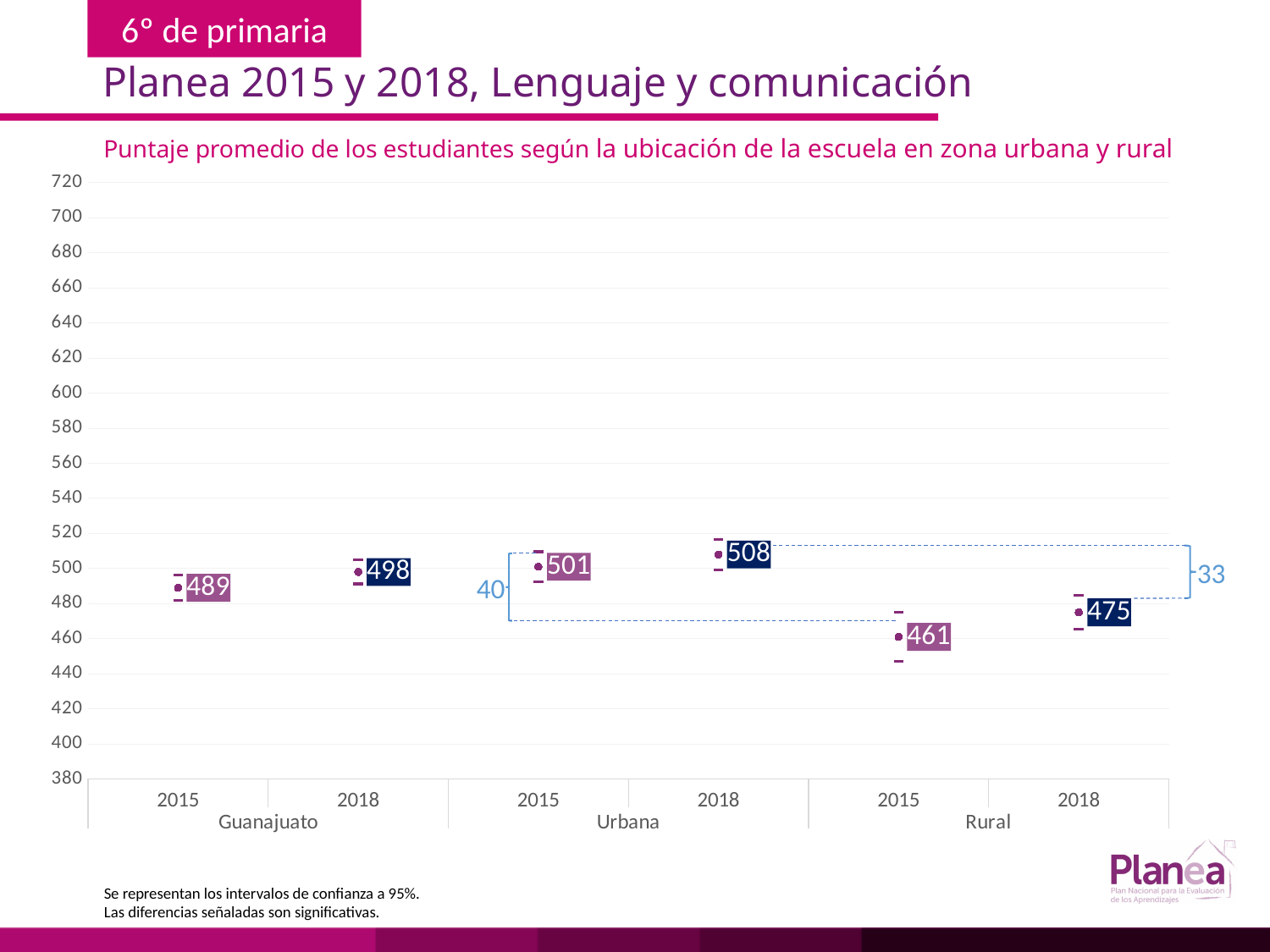
What is the average score for Urbana schools in 2018? 508 What is the average score for Rural schools in 2015? 461 How many data points are plotted on the chart? 6 Do the average scores rise or fall from 2015 to 2018 for each group? rise What is the difference between the Urbana and Rural average scores in 2015? 40 By how many points did the Rural average score change from 2015 to 2018? 14 Which group and year has the lowest average score? Rural 2015 What is the average score for Guanajuato in 2015? 489 What is the difference between the Urbana and Rural average scores in 2018? 33 Which group and year has the highest average score? Urbana 2018 What is the average score for Guanajuato in 2018? 498 Which is larger, the Guanajuato 2018 score or the Urbana 2015 score? Urbana 2015